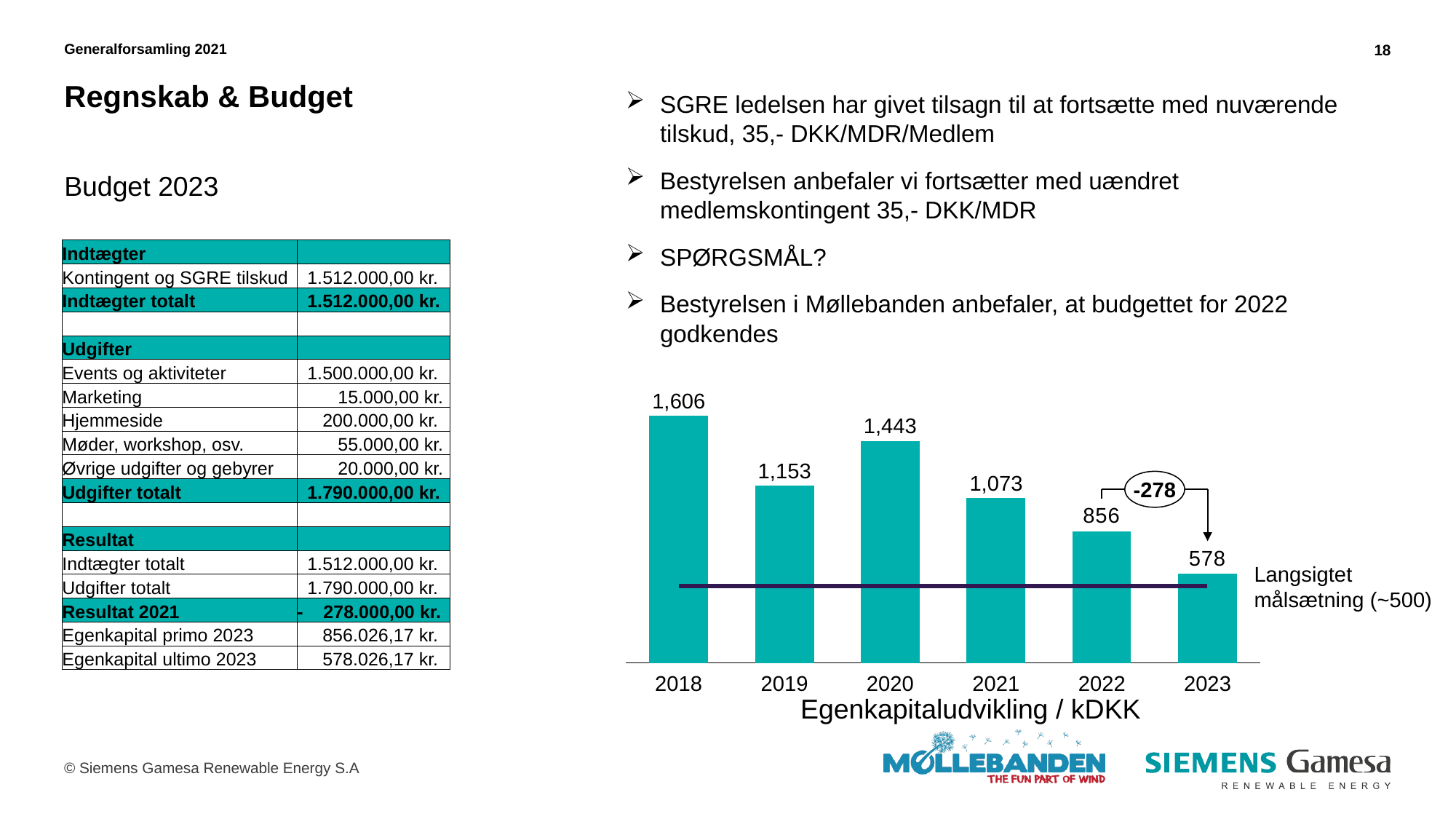
What is the value for 2023 in the Egenkapitaludvikling / kDKK chart? 578 What does the horizontal line across the Egenkapitaludvikling / kDKK chart represent? Langsigtet målsætning (~500) What is the difference between the 2022 and 2023 values in the Egenkapitaludvikling / kDKK chart? 278 What is the value for 2020 in the Egenkapitaludvikling / kDKK chart? 1,443 What is the value for 2018 in the Egenkapitaludvikling / kDKK chart? 1,606 In the Egenkapitaludvikling / kDKK chart, which is larger, the value for 2019 or the value for 2021? 2019 How many years are shown on the x axis of the Egenkapitaludvikling / kDKK chart? 6 Which year has the highest value in the Egenkapitaludvikling / kDKK chart? 2018 Do the values in the Egenkapitaludvikling / kDKK chart generally rise or fall from 2020 to 2023? fall Which year has the lowest value in the Egenkapitaludvikling / kDKK chart? 2023 What kind of chart is the Egenkapitaludvikling / kDKK chart? bar chart What is the difference between the 2018 and 2019 values in the Egenkapitaludvikling / kDKK chart? 453